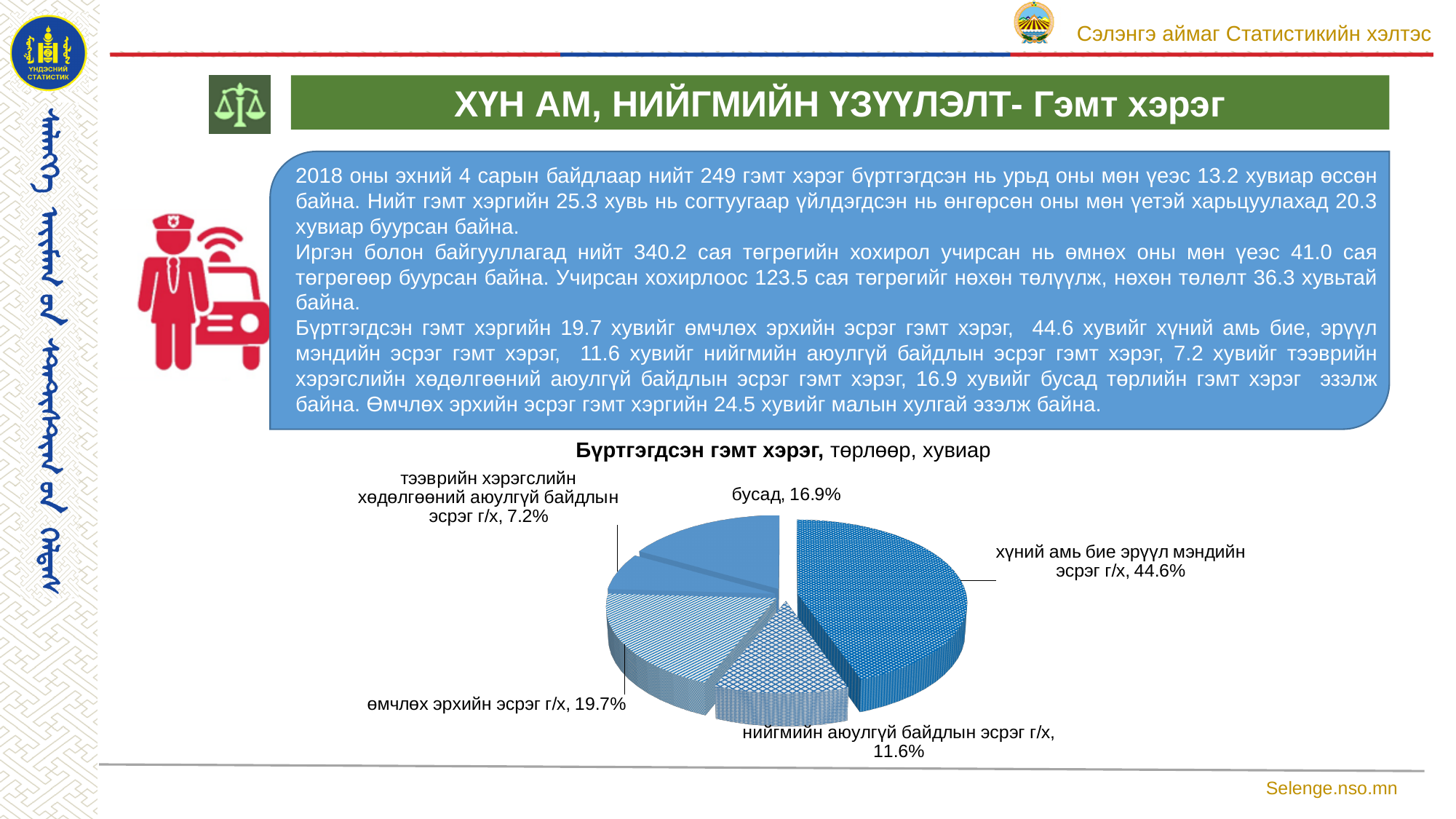
What share of the pie is 'бусад'? 16.9% What share of the pie is 'нийгмийн аюулгүй байдлын эсрэг г/х'? 11.6% What share of the pie is 'тээврийн хэрэгслийн хөдөлгөөний аюулгүй байдлын эсрэг г/х'? 7.2% Which category has the smallest slice of the pie? тээврийн хэрэгслийн хөдөлгөөний аюулгүй байдлын эсрэг г/х What is the difference in percentage points between 'хүний амь бие эрүүл мэндийн эсрэг г/х' and 'өмчлөх эрхийн эсрэг г/х'? 24.9 How many slices does the pie chart have? 5 Which category has the largest slice of the pie? хүний амь бие эрүүл мэндийн эсрэг г/х What share of the pie is 'хүний амь бие эрүүл мэндийн эсрэг г/х'? 44.6% What is the title of the pie chart? Бүртгэгдсэн гэмт хэрэг, төрлөөр, хувиар What kind of chart is shown on the slide? pie chart Which is larger: the share for 'бусад' or the share for 'нийгмийн аюулгүй байдлын эсрэг г/х'? бусад What share of the pie is 'өмчлөх эрхийн эсрэг г/х'? 19.7%